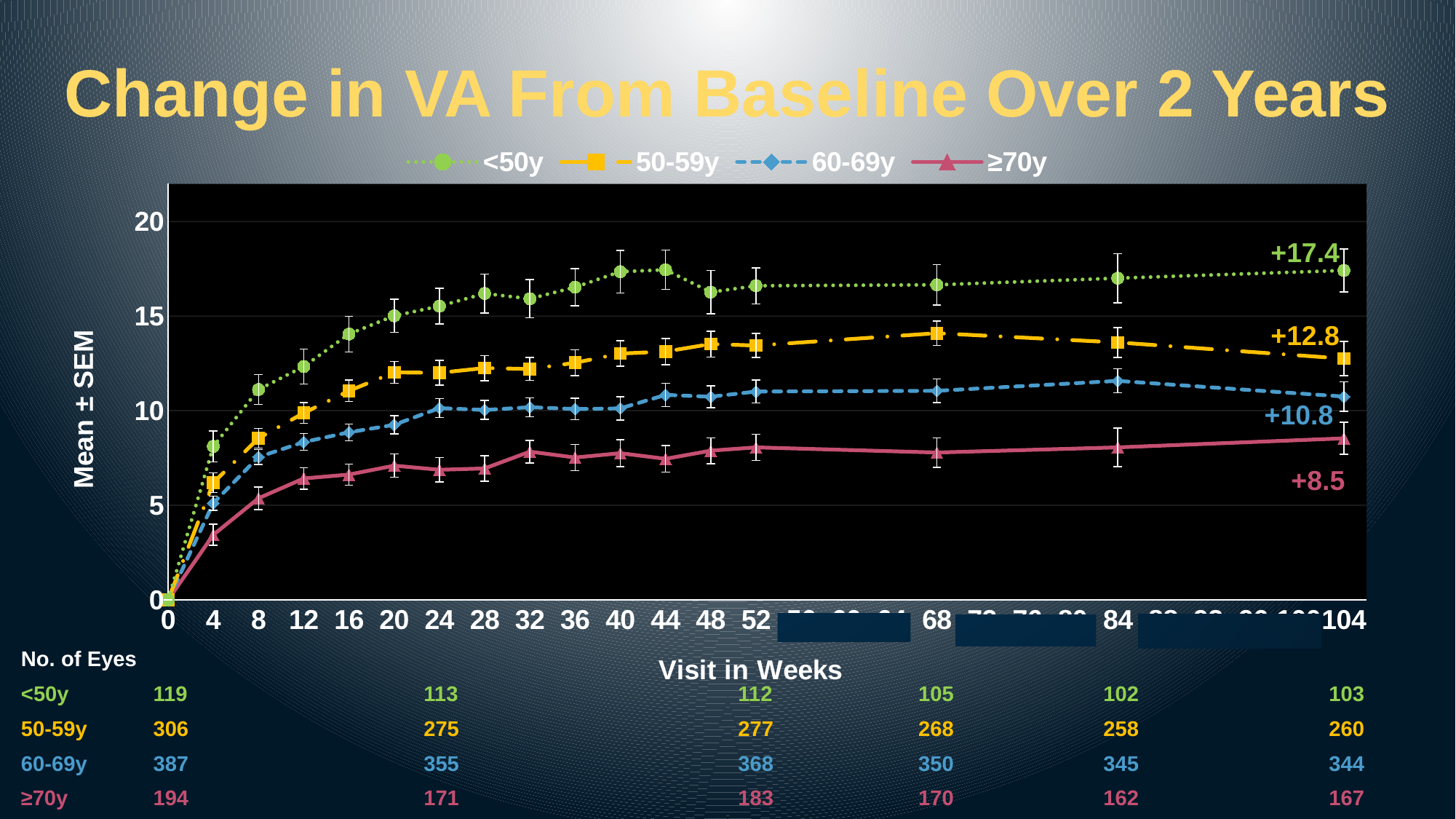
Which age group has the highest value at week 104? <50y What is the labelled value for the ≥70y group at week 104? +8.5 At week 104, which is larger: the 50-59y value or the 60-69y value? 50-59y What is the title of the chart? Change in VA From Baseline Over 2 Years What is the difference between the <50y and ≥70y values at week 104? 8.9 What kind of chart is shown on the slide? line chart How many series does the legend list? 4 What is the labelled value for the 60-69y group at week 104? +10.8 Is the value for the ≥70y group at week 52 greater or less than 10? less What is the labelled value for the <50y group at week 104? +17.4 What is the labelled value for the 50-59y group at week 104? +12.8 Which age group has the lowest value at week 104? ≥70y